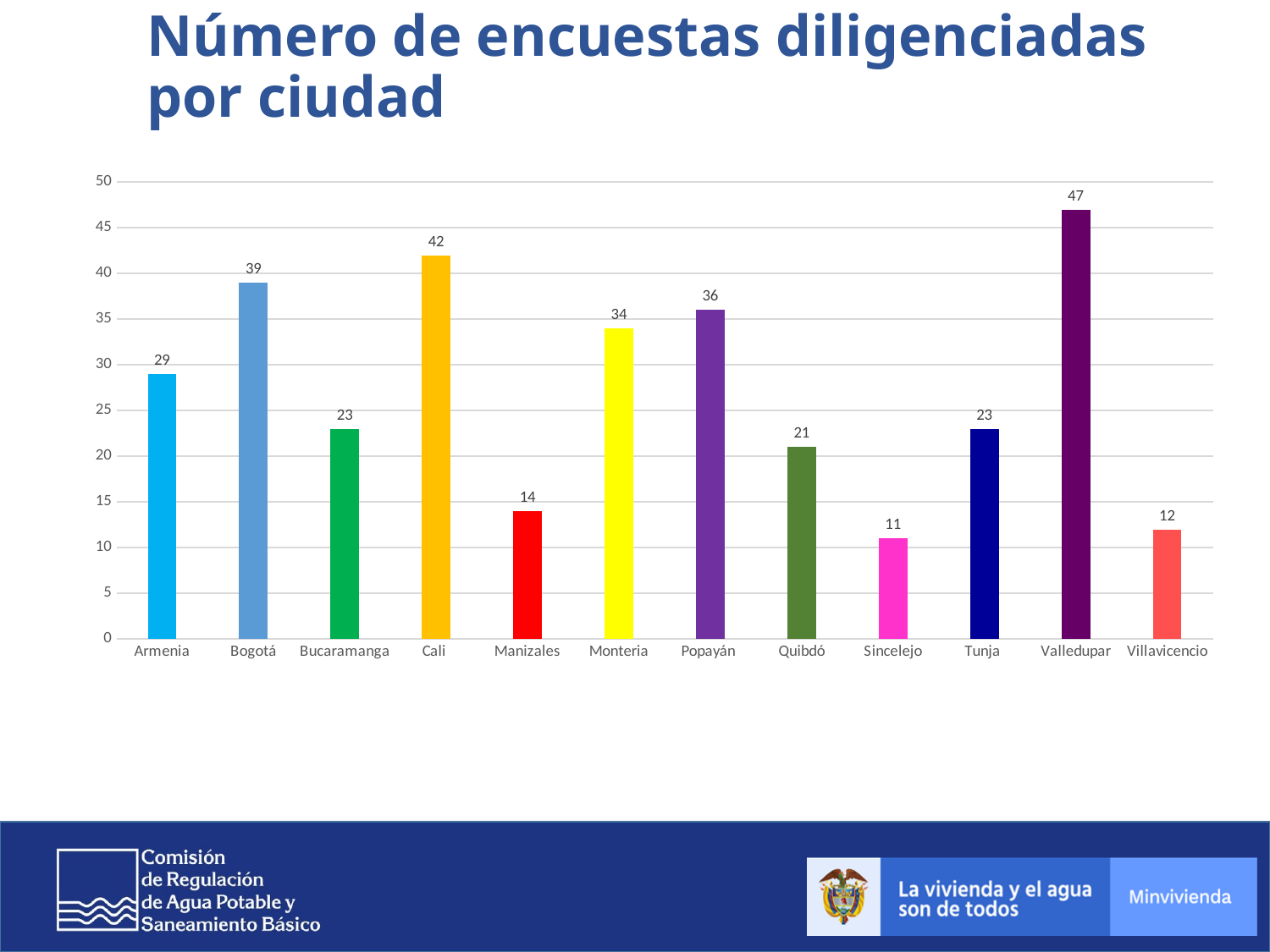
Which city has a larger value, Popayán or Monteria? Popayán What is the title of the slide? Número de encuestas diligenciadas por ciudad How many cities are shown on the x axis of the chart? 12 What type of chart is shown on the slide? bar chart Which city has the highest number of surveys completed? Valledupar Which two cities have the same value of 23? Bucaramanga and Tunja How many surveys were completed in Cali? 42 What is the difference between the values for Valledupar and Bogotá? 8 What is the difference between the values for Manizales and Villavicencio? 2 Which city has the lowest number of surveys completed? Sincelejo Is the value for Armenia greater or less than 25? greater What is the value shown for Sincelejo? 11